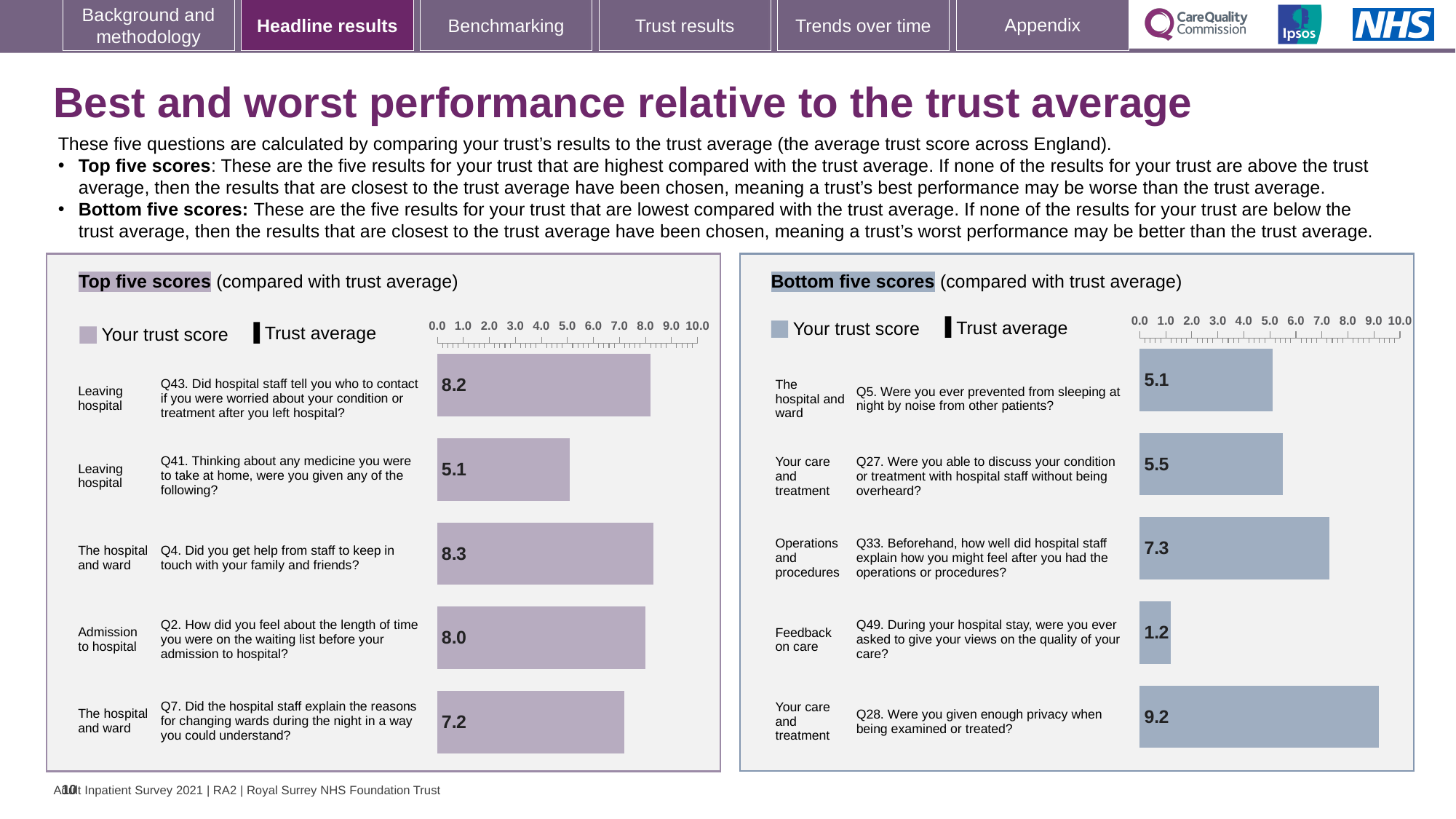
In the Top five scores chart, what is the difference between the trust scores for Q4 and Q41? 3.2 In the Bottom five scores chart, which has the larger trust score, Q5 or Q27? Q27 In the Bottom five scores chart, what is the difference between the trust scores for Q28 and Q49? 8.0 In the Bottom five scores chart, which question has the lowest trust score? Q49 In the Bottom five scores chart, what is the trust score for Q49 (During your hospital stay, were you ever asked to give your views on the quality of your care?)? 1.2 How many questions are shown in the Top five scores chart? 5 In the Top five scores chart, which question has the highest trust score? Q4 What kind of chart is the Top five scores chart? Bar chart In the Bottom five scores chart, is the trust score for Q33 greater or less than 5.0? greater In the Bottom five scores chart, which question has the highest trust score? Q28 In the Top five scores chart, what is the trust score for Q43 (Did hospital staff tell you who to contact if you were worried about your condition or treatment after you left hospital?)? 8.2 In the Top five scores chart, which question has the lowest trust score? Q41